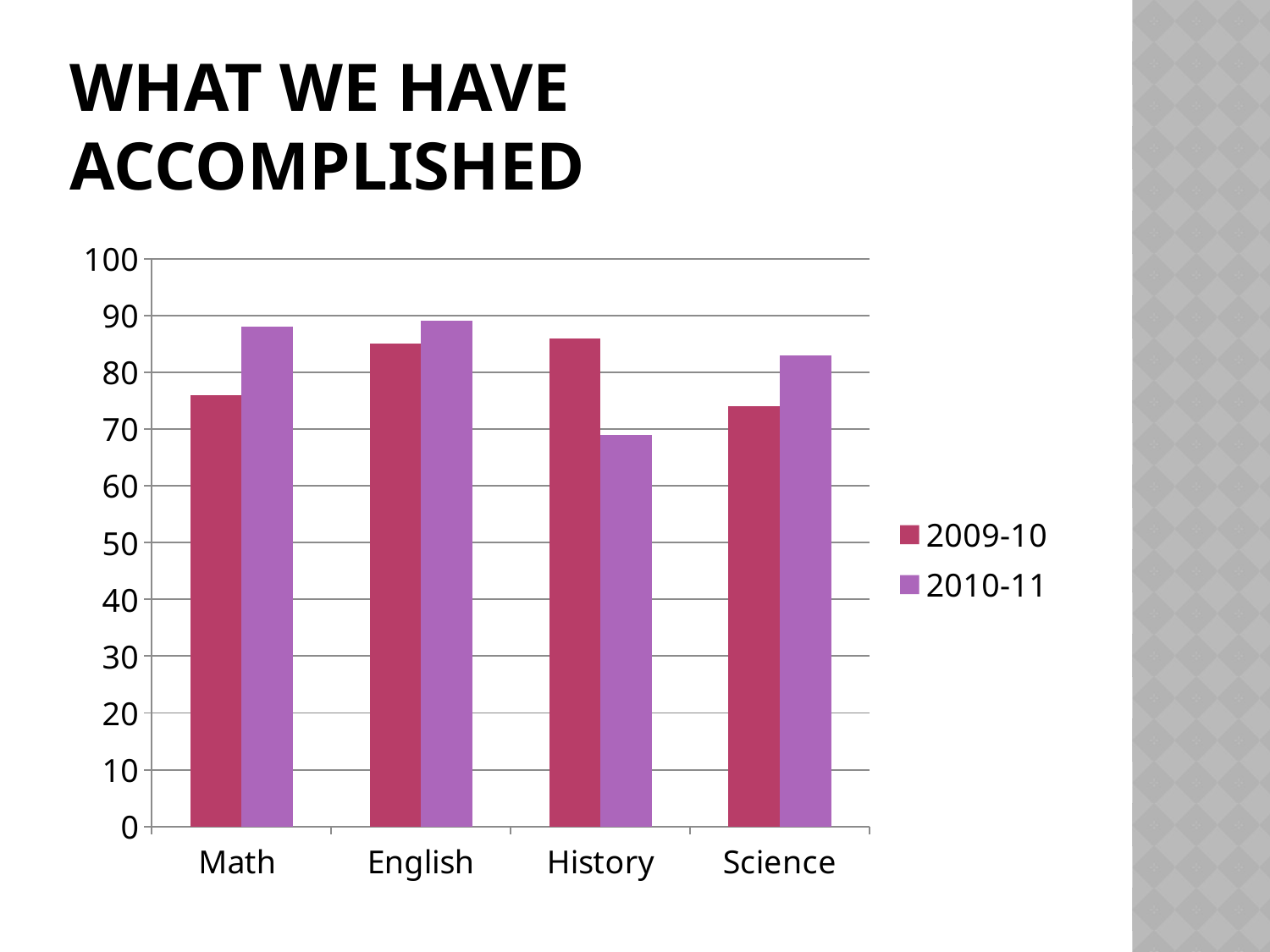
What is the title of the slide containing the chart? What We Have Accomplished Is the 2010-11 value for History greater or less than 60? greater For Math, which series has the larger value, 2009-10 or 2010-11? 2010-11 How many subject categories are shown on the x axis? 4 Is the 2009-10 value for Math greater or less than 80? less For History, which series has the larger value, 2009-10 or 2010-11? 2009-10 What kind of chart is shown on the slide? bar chart Which subject has the lowest value for the 2010-11 series? History How many series does the legend list? 2 Is the 2010-11 value for Science greater or less than 80? greater Which series are listed in the legend? 2009-10 and 2010-11 For Science, which series has the larger value, 2009-10 or 2010-11? 2010-11